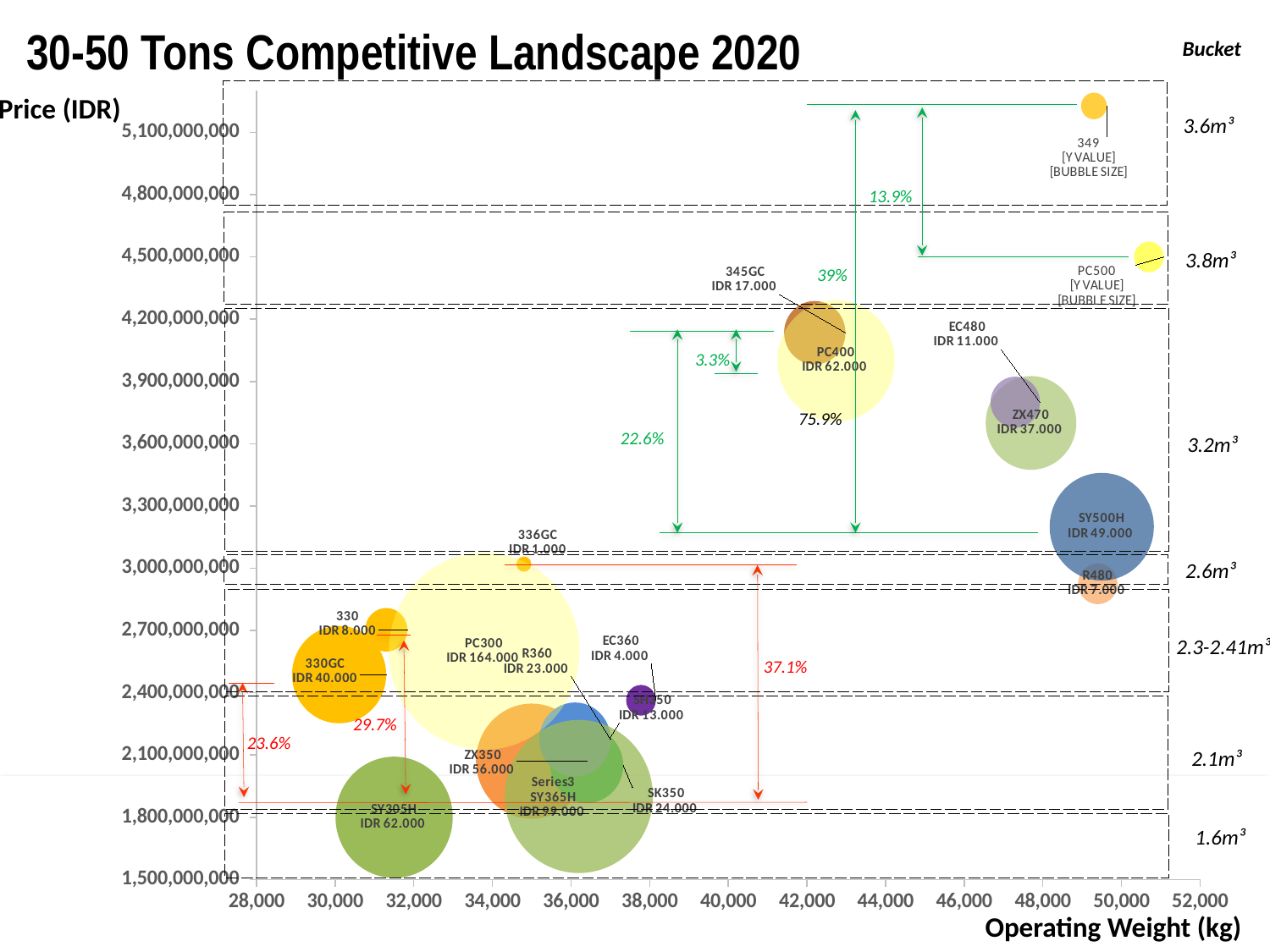
Which has the larger IDR bubble-size value, ZX470 or EC480? ZX470 Which labelled model has the smallest IDR bubble-size value? 336GC What is the difference between the IDR bubble-size values of PC400 and 345GC? IDR 45.000 Is the price value for SY500H greater or less than 3,000,000,000? greater What is the label of the x axis? Operating Weight (kg) What is the IDR bubble-size value labelled for PC300? IDR 164.000 Is the price value for SY305H greater or less than 2,100,000,000? less What is the IDR bubble-size value labelled for SY500H? IDR 49.000 What is the title of the chart? 30-50 Tons Competitive Landscape 2020 What kind of chart is shown on the slide? bubble chart Which labelled model has the largest IDR bubble-size value? PC300 What is the IDR bubble-size value labelled for ZX350? IDR 56.000